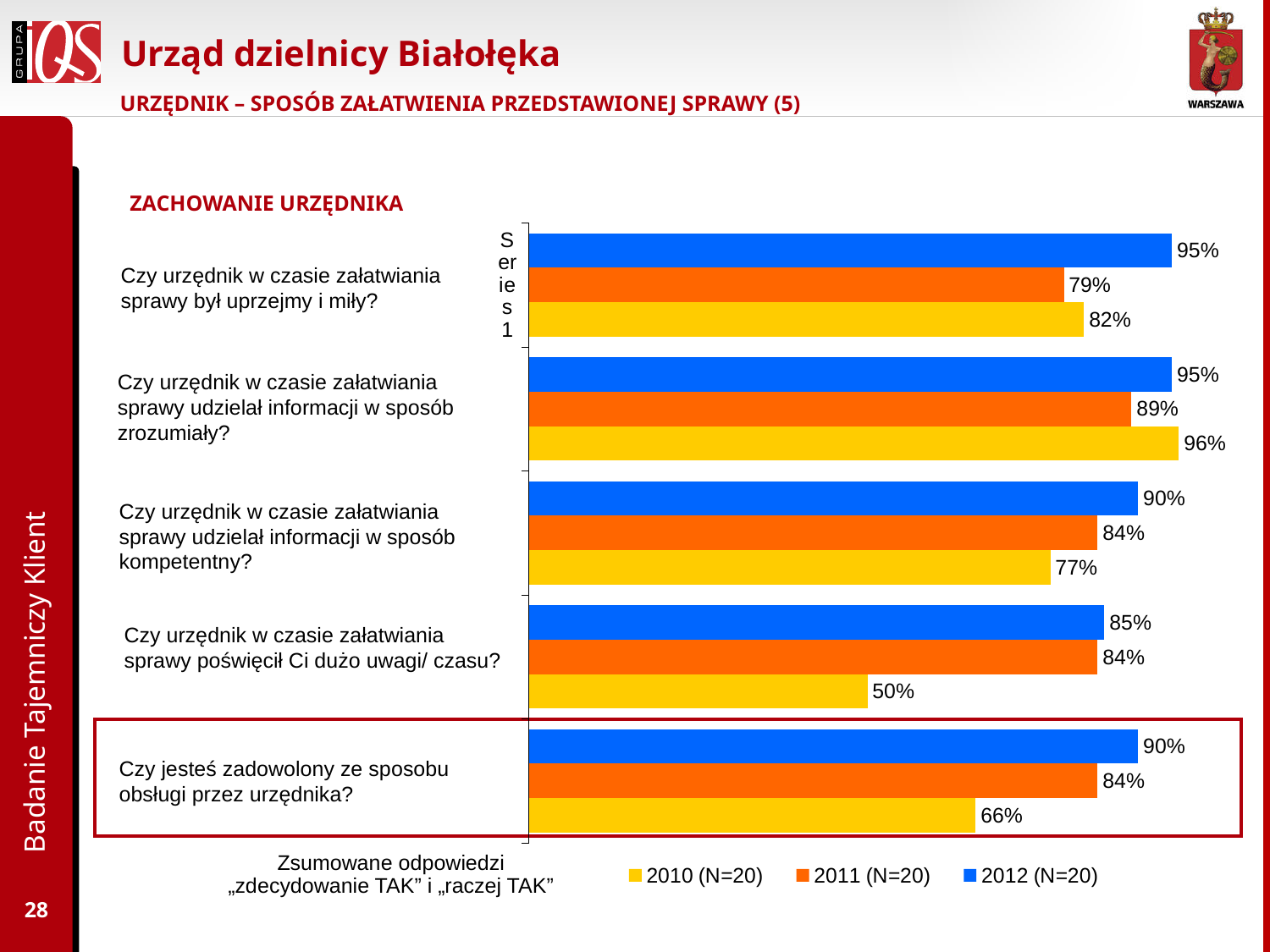
How many series does the legend list? 3 Which colour represents the 2012 (N=20) series in the chart? blue What is the 2011 value for "Czy jesteś zadowolony ze sposobu obsługi przez urzędnika?"? 84% What is the 2012 value for "Czy urzędnik w czasie załatwiania sprawy był uprzejmy i miły?"? 95% What is the difference between the 2011 and 2010 values for "Czy urzędnik w czasie załatwiania sprawy udzielał informacji w sposób kompetentny?"? 7% What kind of chart is shown on the slide? bar chart Which question has the lowest 2010 value? Czy urzędnik w czasie załatwiania sprawy poświęcił Ci dużo uwagi/ czasu? What is the 2010 value for "Czy urzędnik w czasie załatwiania sprawy poświęcił Ci dużo uwagi/ czasu?"? 50% Which question has the highest 2010 value? Czy urzędnik w czasie załatwiania sprawy udzielał informacji w sposób zrozumiały? How many questions (categories) are plotted in the chart? 5 What is the difference between the 2012 and 2010 values for "Czy jesteś zadowolony ze sposobu obsługi przez urzędnika?"? 24% For "Czy urzędnik w czasie załatwiania sprawy udzielał informacji w sposób zrozumiały?", which is larger: the 2010 value or the 2012 value? 2010